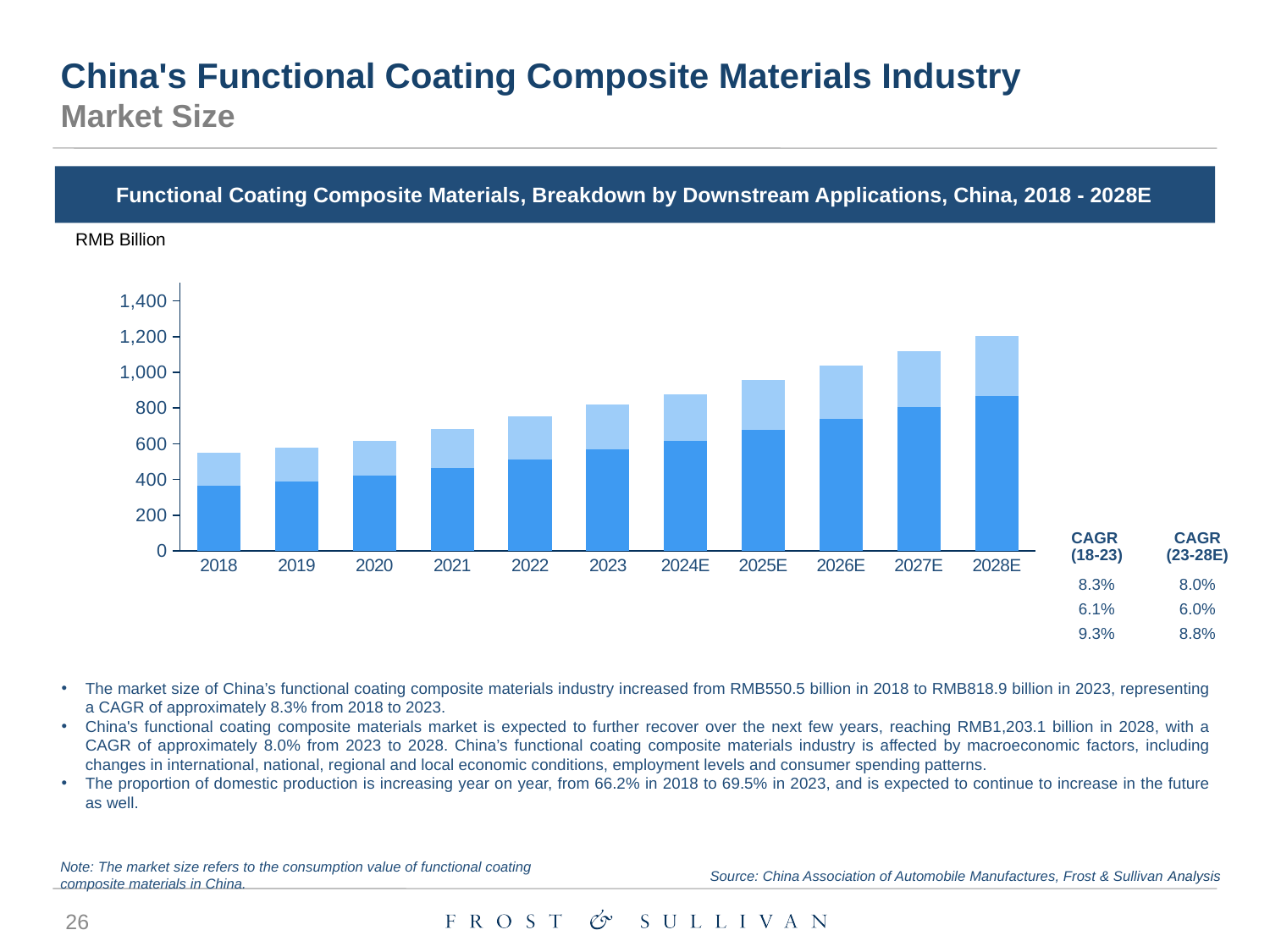
Is the total bar for 2018 greater or less than 400? greater Do the bar totals rise or fall from 2018 to 2028E? Rise Which year has the shortest bar in the chart? 2018 How many years (categories) are shown on the x axis of the chart? 11 Which bar is taller, 2021 or 2026E? 2026E Is the total bar for 2022 greater or less than 800? less Which year has the tallest bar in the chart? 2028E Is the total bar for 2018 greater or less than 600? less What kind of chart is shown on the slide? Stacked bar chart What unit is shown above the y axis of the chart? RMB Billion